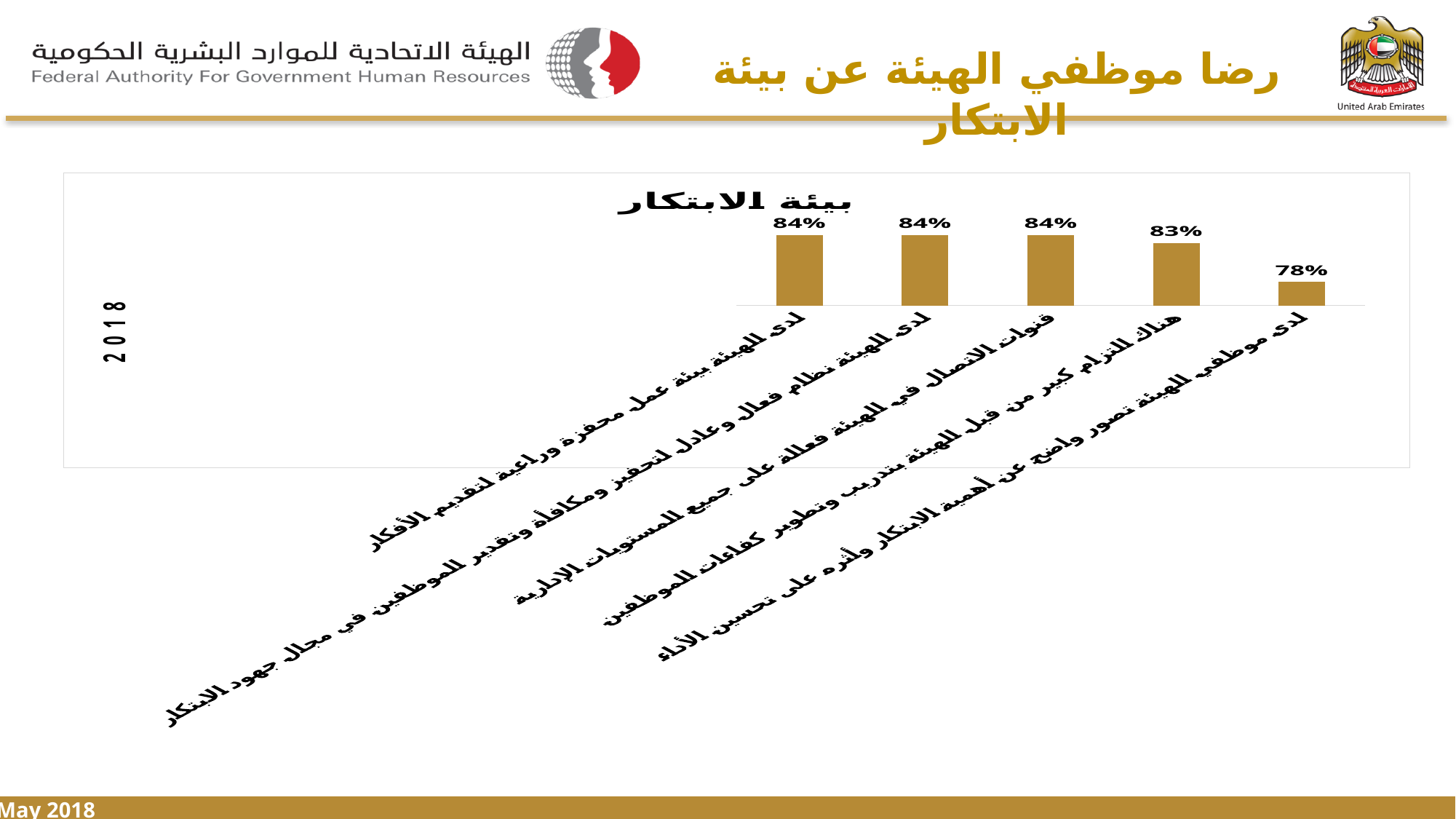
What is the title of the chart? بيئة الابتكار How many bars does the chart show? 5 What is the difference between the value for "لدى الهيئة بيئة عمل محفزة وراعية لتقديم الأفكار" and the value for "لدى موظفي الهيئة تصور واضح عن أهمية الابتكار وأثره على تحسين الأداء"? 6% What is the difference between the value for "هناك التزام كبير من قبل الهيئة بتدريب وتطوير كفاءات الموظفين" and the value for "لدى موظفي الهيئة تصور واضح عن أهمية الابتكار وأثره على تحسين الأداء"? 5% What kind of chart is shown on the slide? bar chart What is the value for "لدى موظفي الهيئة تصور واضح عن أهمية الابتكار وأثره على تحسين الأداء"? 78% What is the value for "هناك التزام كبير من قبل الهيئة بتدريب وتطوير كفاءات الموظفين"? 83% Which category has the lowest value? لدى موظفي الهيئة تصور واضح عن أهمية الابتكار وأثره على تحسين الأداء Which is larger: the value for "هناك التزام كبير من قبل الهيئة بتدريب وتطوير كفاءات الموظفين" or the value for "لدى موظفي الهيئة تصور واضح عن أهمية الابتكار وأثره على تحسين الأداء"? هناك التزام كبير من قبل الهيئة بتدريب وتطوير كفاءات الموظفين What is the value for "لدى الهيئة بيئة عمل محفزة وراعية لتقديم الأفكار"? 84% What year is shown as the vertical axis label of the chart? 2018 What is the value for "قنوات الاتصال في الهيئة فعالة على جميع المستويات الإدارية"? 84%